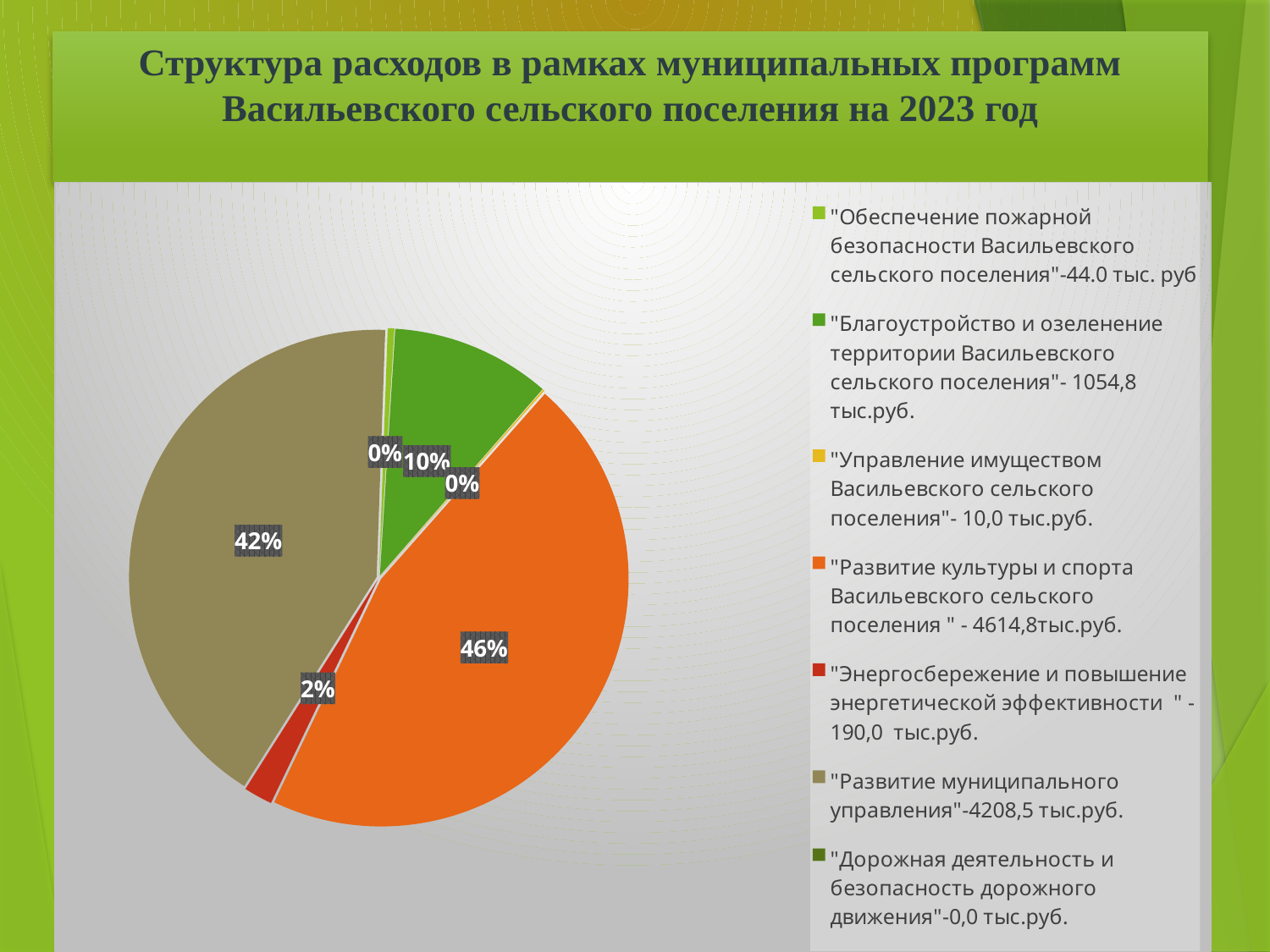
What share of the pie does "Благоустройство и озеленение территории Васильевского сельского поселения" take? 10% What is the title of the slide containing the pie chart? Структура расходов в рамках муниципальных программ Васильевского сельского поселения на 2023 год What kind of chart is shown on the slide? pie chart What share of the pie does "Энергосбережение и повышение энергетической эффективности" take? 2% Which is larger: the slice for "Развитие культуры и спорта" or the slice for "Развитие муниципального управления"? "Развитие культуры и спорта" What is the difference in percentage points between the "Развитие культуры и спорта" slice and the "Развитие муниципального управления" slice? 4% What share of the pie does "Развитие культуры и спорта Васильевского сельского поселения" take? 46% What amount in thousand rubles does the legend give for "Развитие муниципального управления"? 4208,5 тыс.руб. Which is larger: the slice for "Благоустройство и озеленение территории" or the slice for "Энергосбережение и повышение энергетической эффективности"? "Благоустройство и озеленение территории" How many entries does the legend of the pie chart list? 7 Which program has the largest slice of the pie? "Развитие культуры и спорта Васильевского сельского поселения"